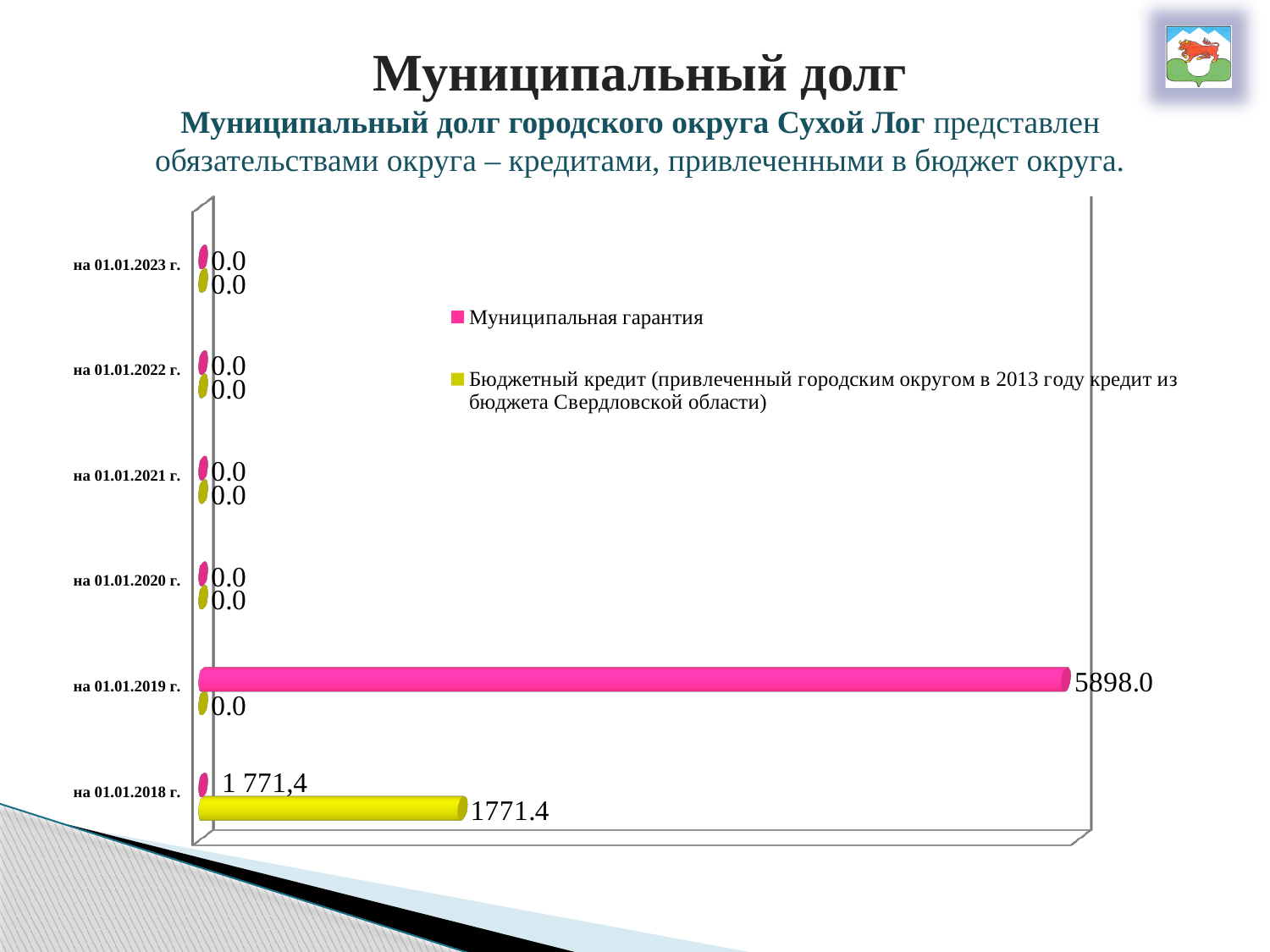
What kind of chart is shown on the slide? bar chart For which date is the Бюджетный кредит value highest? на 01.01.2018 г. For which date is the Муниципальная гарантия value highest? на 01.01.2019 г. What is the value of Бюджетный кредит for на 01.01.2018 г.? 1771.4 How many date categories are shown on the chart's vertical axis? 6 What is the value of Муниципальная гарантия for на 01.01.2023 г.? 0.0 How many series does the chart legend list? 2 What is the value of Бюджетный кредит for на 01.01.2019 г.? 0.0 What is the difference between Муниципальная гарантия for на 01.01.2019 г. (5898.0) and Бюджетный кредит for на 01.01.2018 г. (1771.4)? 4126.6 What is the value of Муниципальная гарантия for на 01.01.2019 г.? 5898.0 Which is larger: Муниципальная гарантия for на 01.01.2019 г. or Бюджетный кредит for на 01.01.2018 г.? Муниципальная гарантия for на 01.01.2019 г. Which colour represents the Муниципальная гарантия series in the chart? pink